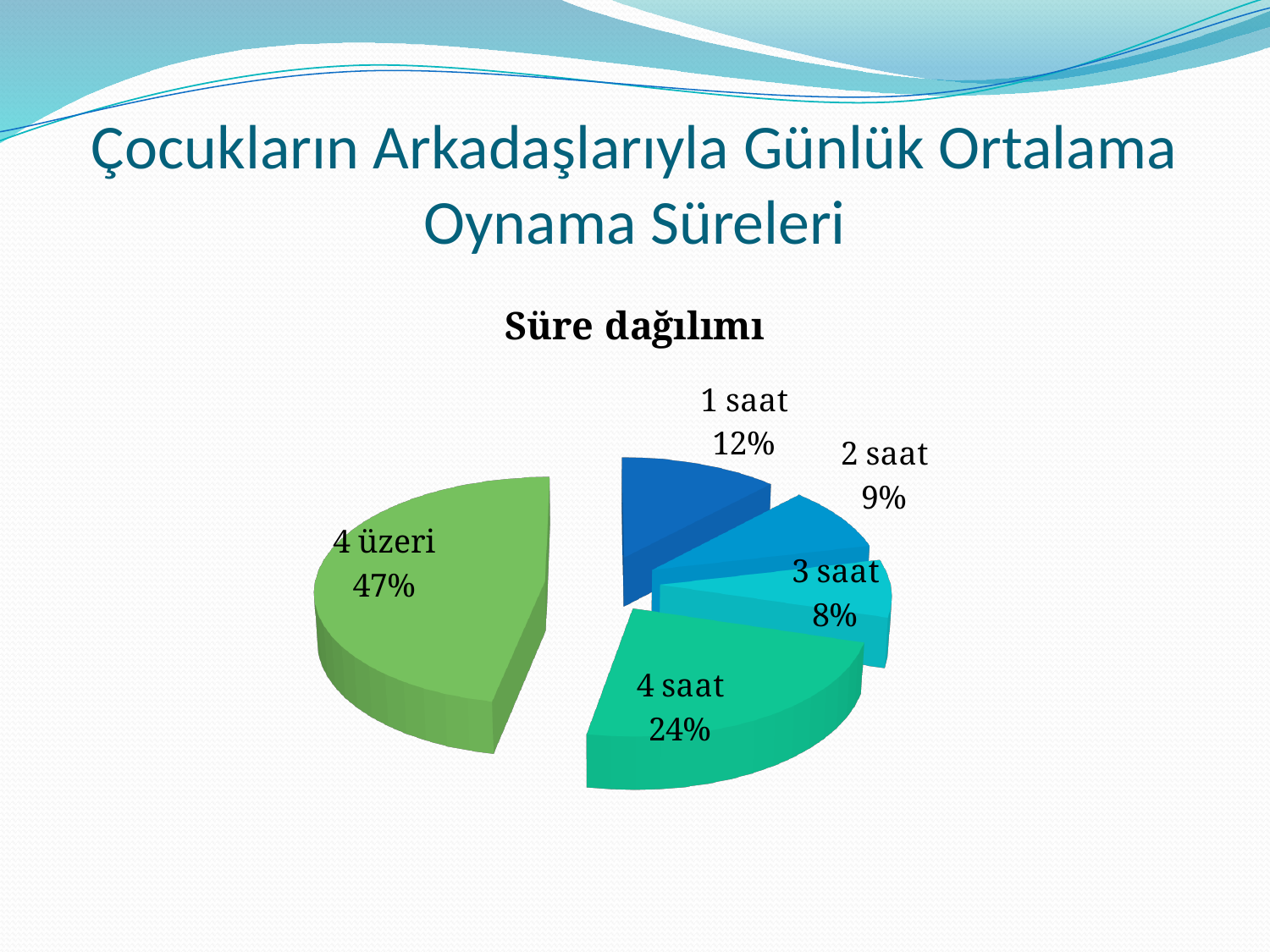
Which category has the largest share of the pie? 4 üzeri What is the value for '3 saat'? 8% What is the chart's title? Süre dağılımı What share of the pie does the '4 üzeri' slice represent? 47% How many slices does the pie chart have? 5 Which category has the smallest share of the pie? 3 saat What is the value for '1 saat'? 12% What is the value for '4 saat'? 24% What is the difference between the shares for '4 üzeri' and '4 saat'? 23% What kind of chart is shown on the slide? pie chart What is the value for '2 saat'? 9% Which is larger, the share for '1 saat' or the share for '2 saat'? 1 saat